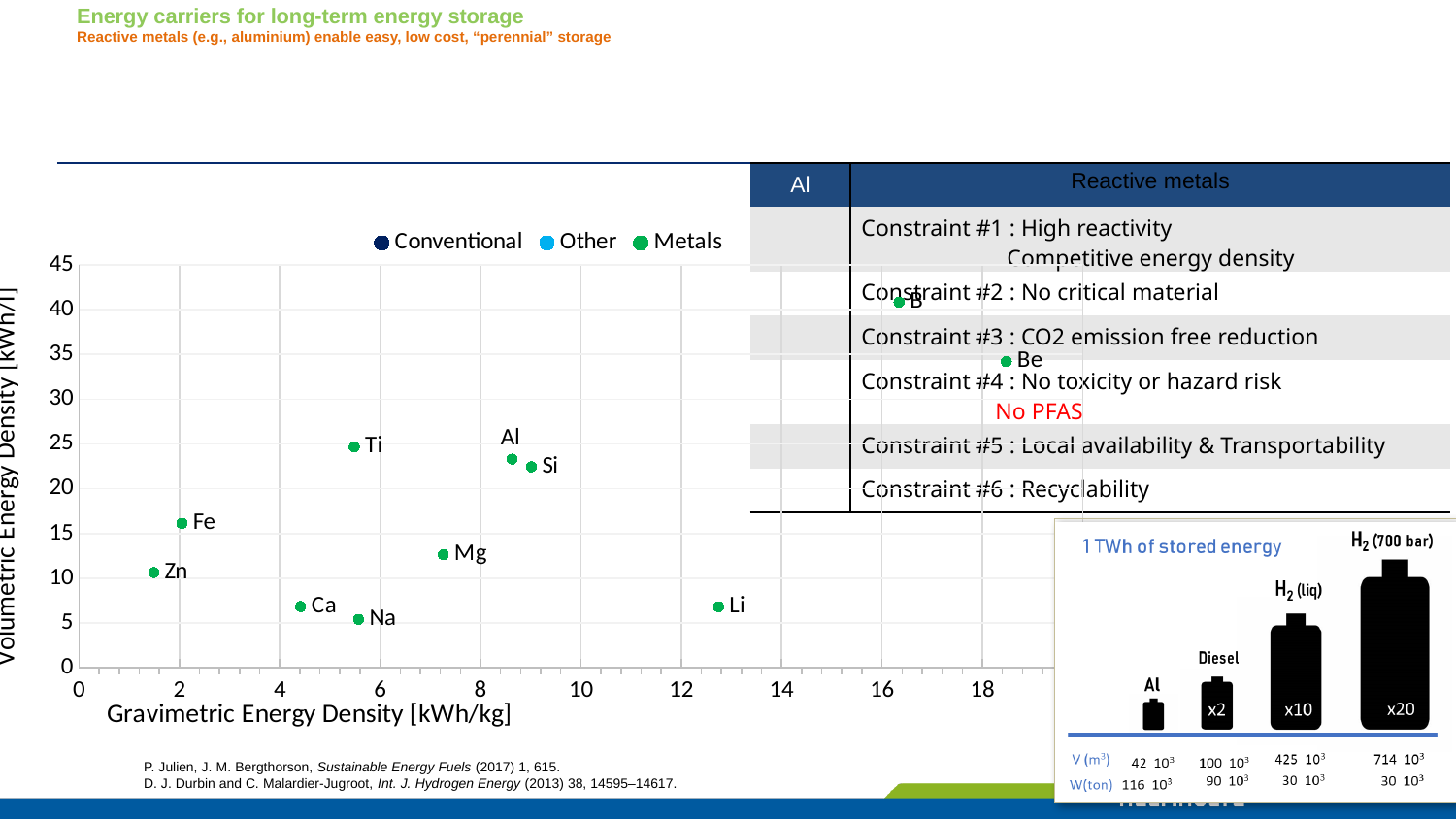
What is the label of the x axis of the chart? Gravimetric Energy Density [kWh/kg] Is the gravimetric energy density for Li greater or less than 10 kWh/kg? greater Which labeled element has the highest volumetric energy density on the chart? B Which labeled element has the highest gravimetric energy density on the chart? Li Is the volumetric energy density for B greater or less than 35 kWh/l? greater Which labeled element has the lowest volumetric energy density on the chart? Na Which has the higher volumetric energy density, Ti or Fe? Ti What kind of chart is shown on the slide? Scatter chart Is the volumetric energy density for Na greater or less than 10 kWh/l? less Which has the higher volumetric energy density, Mg or Ca? Mg How many series does the chart legend list? 3 Which labeled element has the lowest gravimetric energy density on the chart? Zn